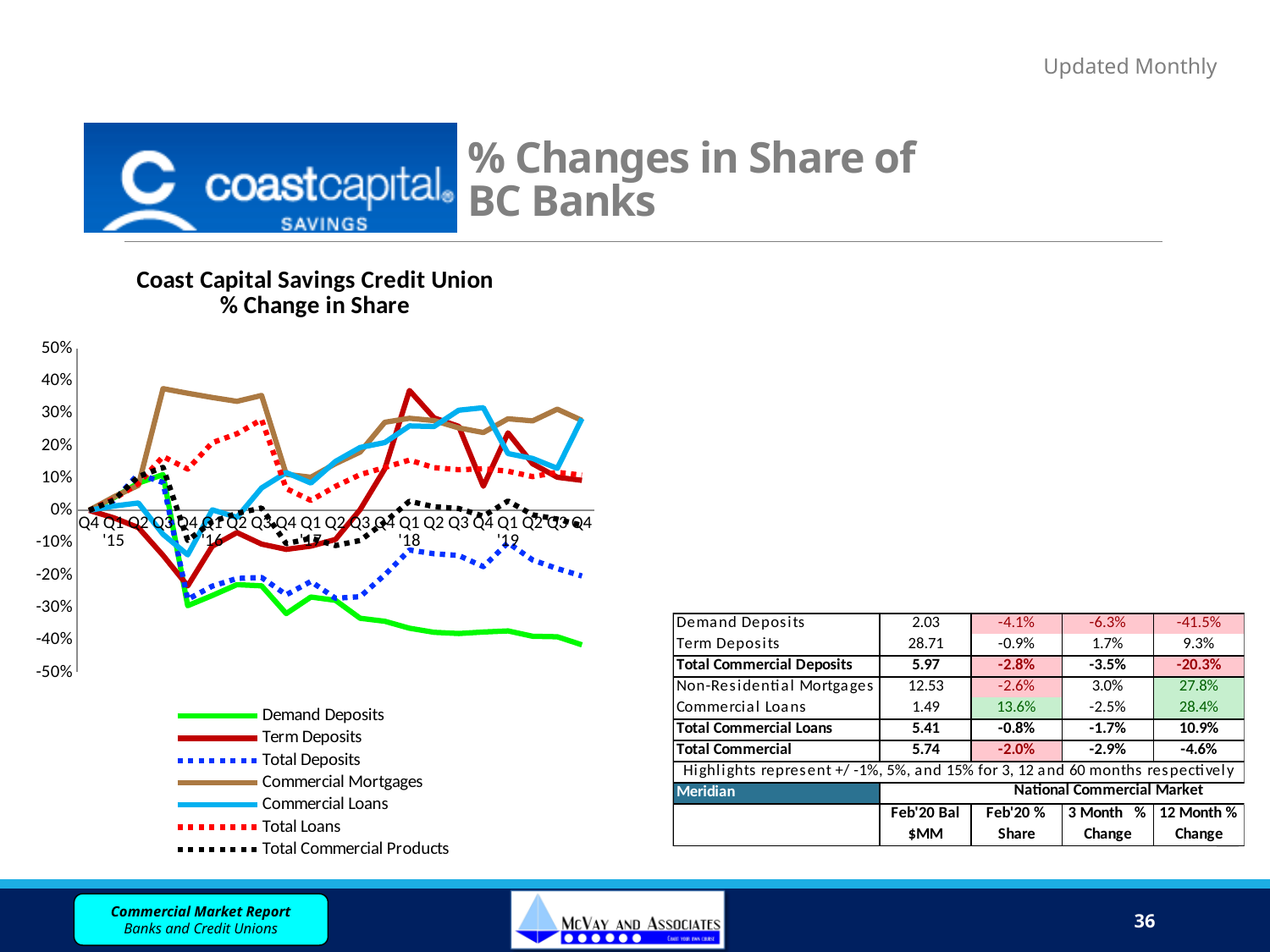
Is the peak value of Term Deposits at Q1 '18 greater or less than 30%? greater Which series has the lowest value at Q4 '19 in the chart? Demand Deposits How many quarters are plotted along the x axis of the chart? 21 What is the title of the chart? Coast Capital Savings Credit Union % Change in Share Is the value for Total Deposits at Q4 '19 greater or less than -10%? less Does the Demand Deposits line generally rise or fall from Q4 '15 to Q4 '19? Fall At Q4 '19, which is larger: the value for Term Deposits or the value for Demand Deposits? Term Deposits Is the value for Commercial Loans at Q4 '19 greater or less than 20%? greater How many series does the chart's legend list? 7 Which series is drawn as a solid green line in the chart? Demand Deposits What kind of chart is shown on the slide? Line chart